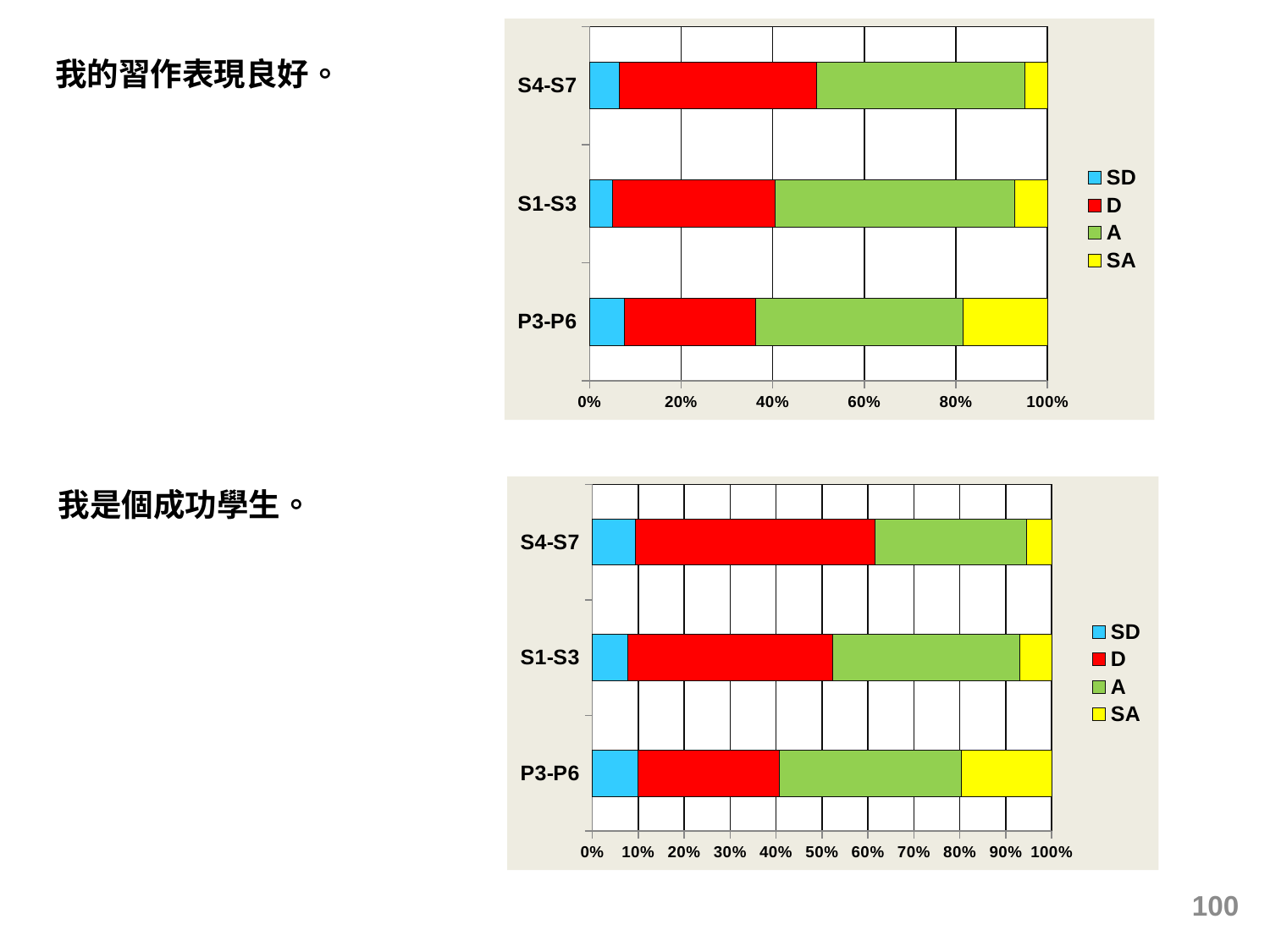
In the bottom chart, which category has the smallest D segment? P3-P6 In the top chart, which category has the largest SA segment? P3-P6 In the top chart, is the SD share for S1-S3 greater or less than 20%? less How many categories are shown on the y axis of the top chart? 3 In the top chart, is the combined SD and D share for S4-S7 greater or less than 40%? greater In the bottom chart, which category has the largest D segment? S4-S7 In the top chart, is the SA segment larger for P3-P6 or for S4-S7? P3-P6 How many series does the legend of the bottom chart list? 4 What are the legend entries of the top chart, from top to bottom? SD, D, A, SA In the bottom chart, which colour represents the series D? Red What kind of chart is the top chart on the slide? Stacked bar chart In the bottom chart, is the combined SD and D share for P3-P6 greater or less than 50%? less